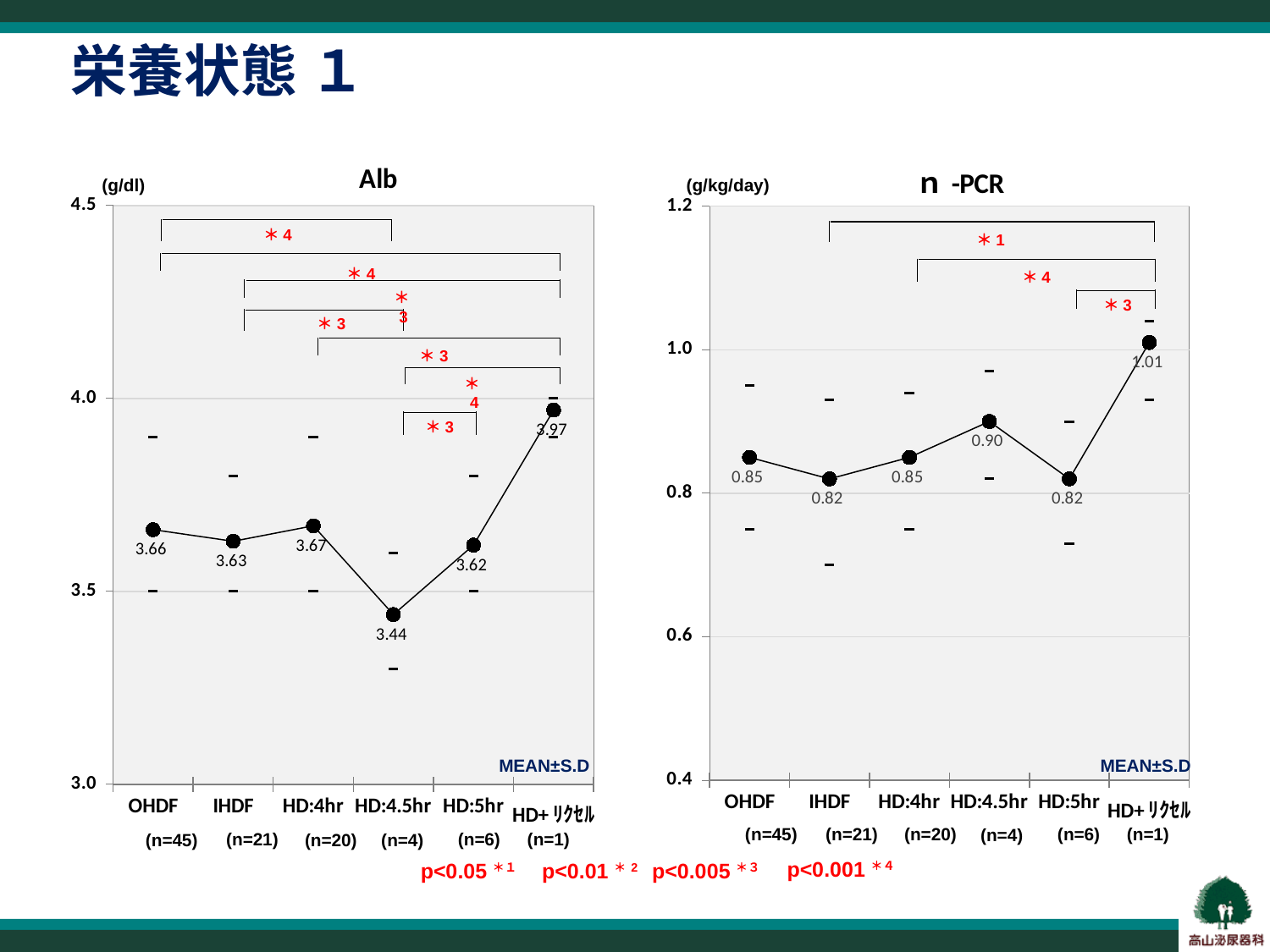
How many categories are plotted on the x axis of the Alb chart? 6 In the n-PCR chart, which category has the highest value? HD+リクセル In the n-PCR chart, what is the value for HD:4.5hr? 0.90 In the Alb chart, what is the difference between the values for HD+リクセル and HD:4.5hr? 0.53 What kind of chart is the n-PCR chart? line chart In the Alb chart, which category has the lowest value? HD:4.5hr In the Alb chart, what is the value for HD+リクセル? 3.97 In the Alb chart, what is the value for HD:4.5hr? 3.44 In the n-PCR chart, what is the value for IHDF? 0.82 In the Alb chart, which is larger, the value for OHDF or the value for IHDF? OHDF In the n-PCR chart, what is the difference between the values for HD+リクセル and HD:4.5hr? 0.11 In the n-PCR chart, is the value for HD+リクセル greater or less than 1.0? greater